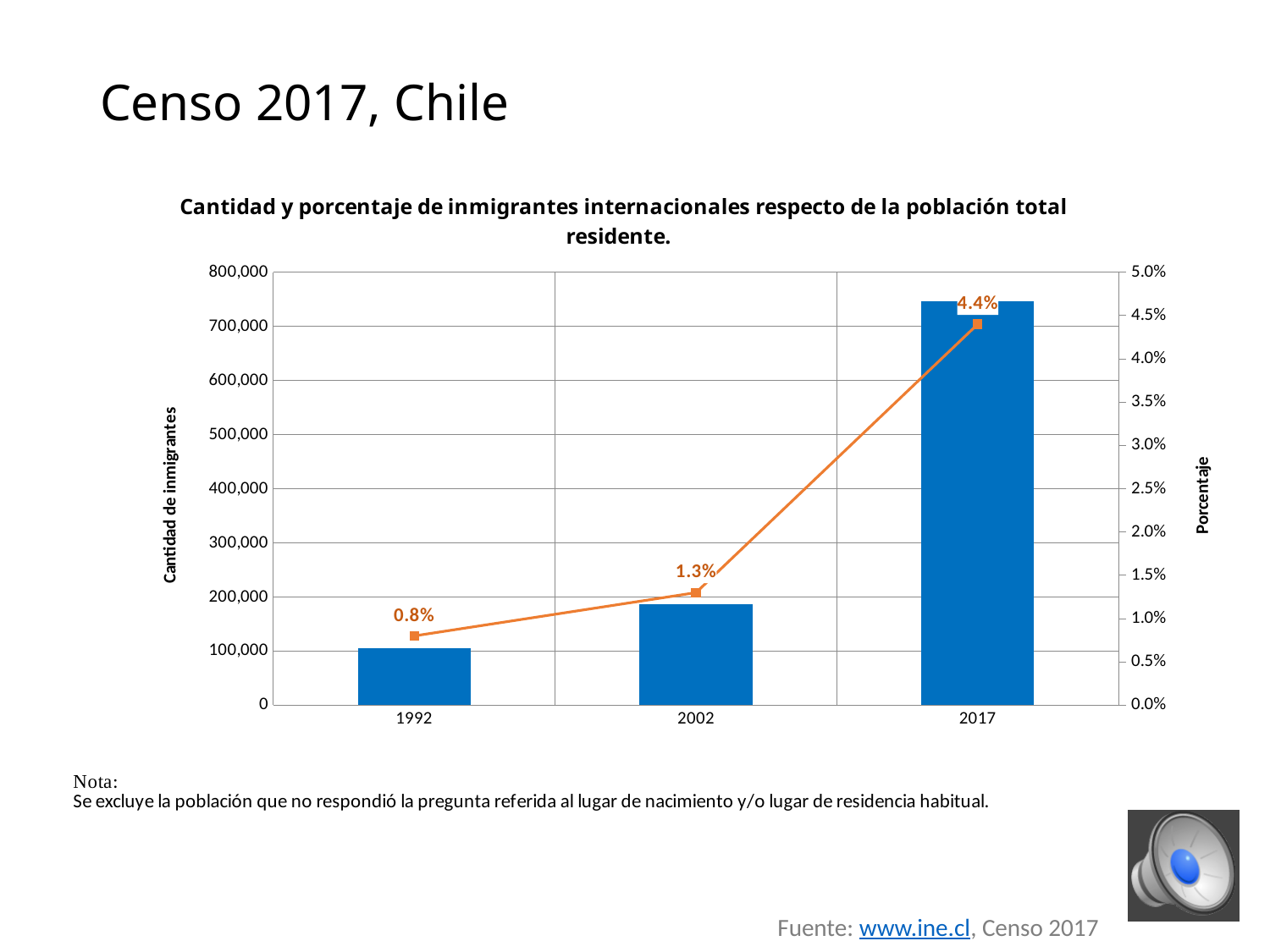
Which year has the highest percentage of international immigrants? 2017 Do the values rise or fall from 1992 to 2017? rise What percentage is shown for 2017? 4.4% What percentage is shown for 1992? 0.8% Is the number of immigrants for 2017 greater or less than 700,000? greater What percentage is shown for 2002? 1.3% Which year has a larger number of immigrants, 2002 or 1992? 2002 What is the difference in percentage between 2017 and 2002? 3.1% Which year has the lowest number of immigrants? 1992 How many years are shown on the x axis? 3 Is the number of immigrants for 1992 greater or less than 200,000? less What is the difference in percentage between 2002 and 1992? 0.5%